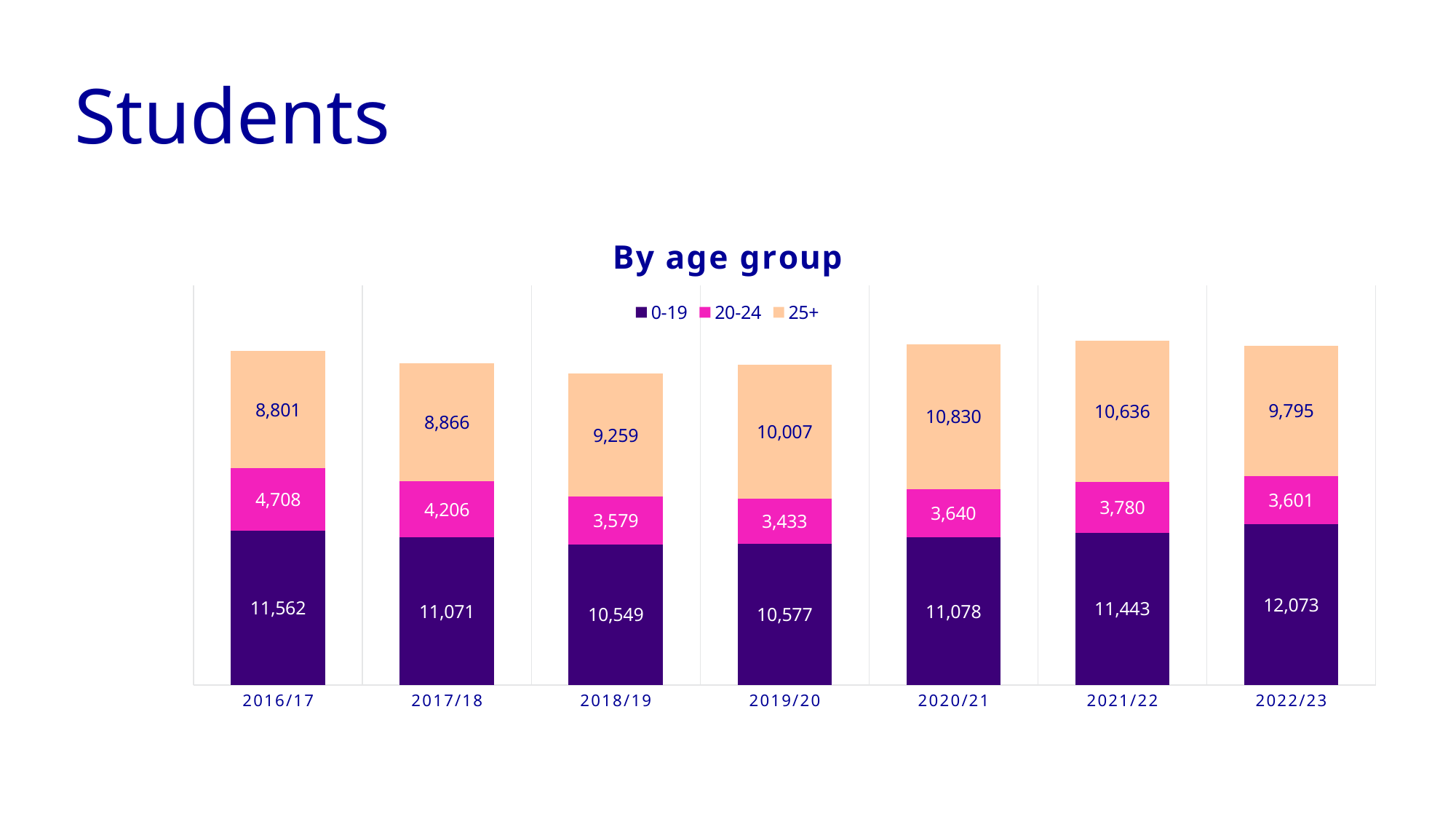
What is the value for the 0-19 age group in 2016/17? 11,562 How many years are shown on the x axis? 7 In which year is the 20-24 age group value lowest? 2019/20 What is the total of the stacked bar for 2022/23? 25,469 In which year is the 0-19 age group value highest? 2022/23 What is the value for the 20-24 age group in 2021/22? 3,780 How many series does the legend list? 3 In which year is the 25+ age group value highest? 2020/21 What is the difference between the 25+ value in 2020/21 and in 2016/17? 2,029 What is the value for the 25+ age group in 2019/20? 10,007 Which is larger: the 0-19 value in 2017/18 or in 2020/21? 2020/21 What is the title of the chart? By age group